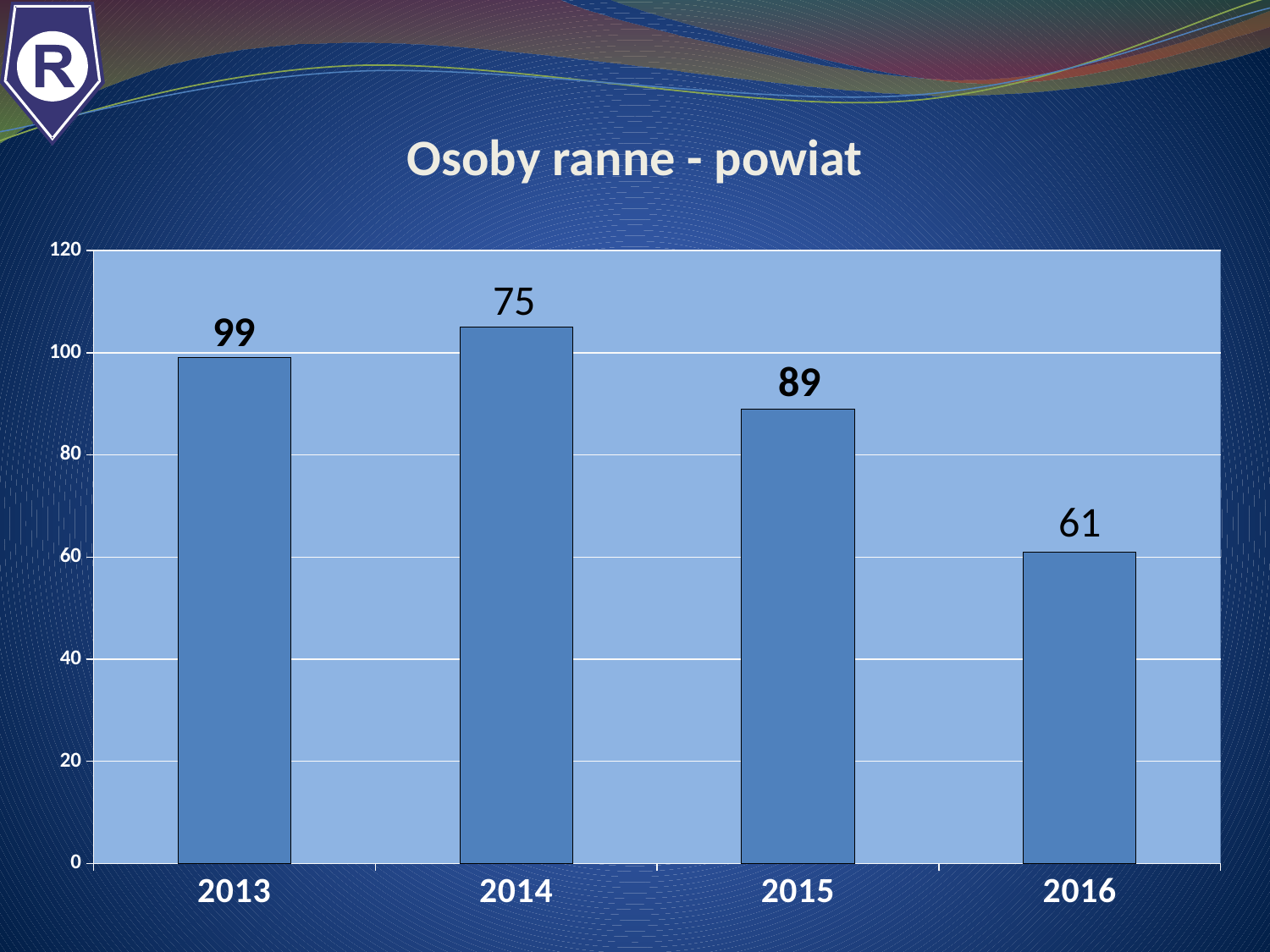
Which is larger, the value for 2013 or the value for 2015? 2013 How many years are shown on the x axis? 4 What is the title of the chart? Osoby ranne - powiat What is the difference between the values for 2015 and 2016? 28 Which year has the lowest value? 2016 What is the value for 2013? 99 What kind of chart is shown on the slide? bar chart What is the value for 2016? 61 Is the value for 2016 greater or less than 80? less What is the difference between the values for 2013 and 2015? 10 Which is larger, the value for 2015 or the value for 2016? 2015 What is the value for 2015? 89